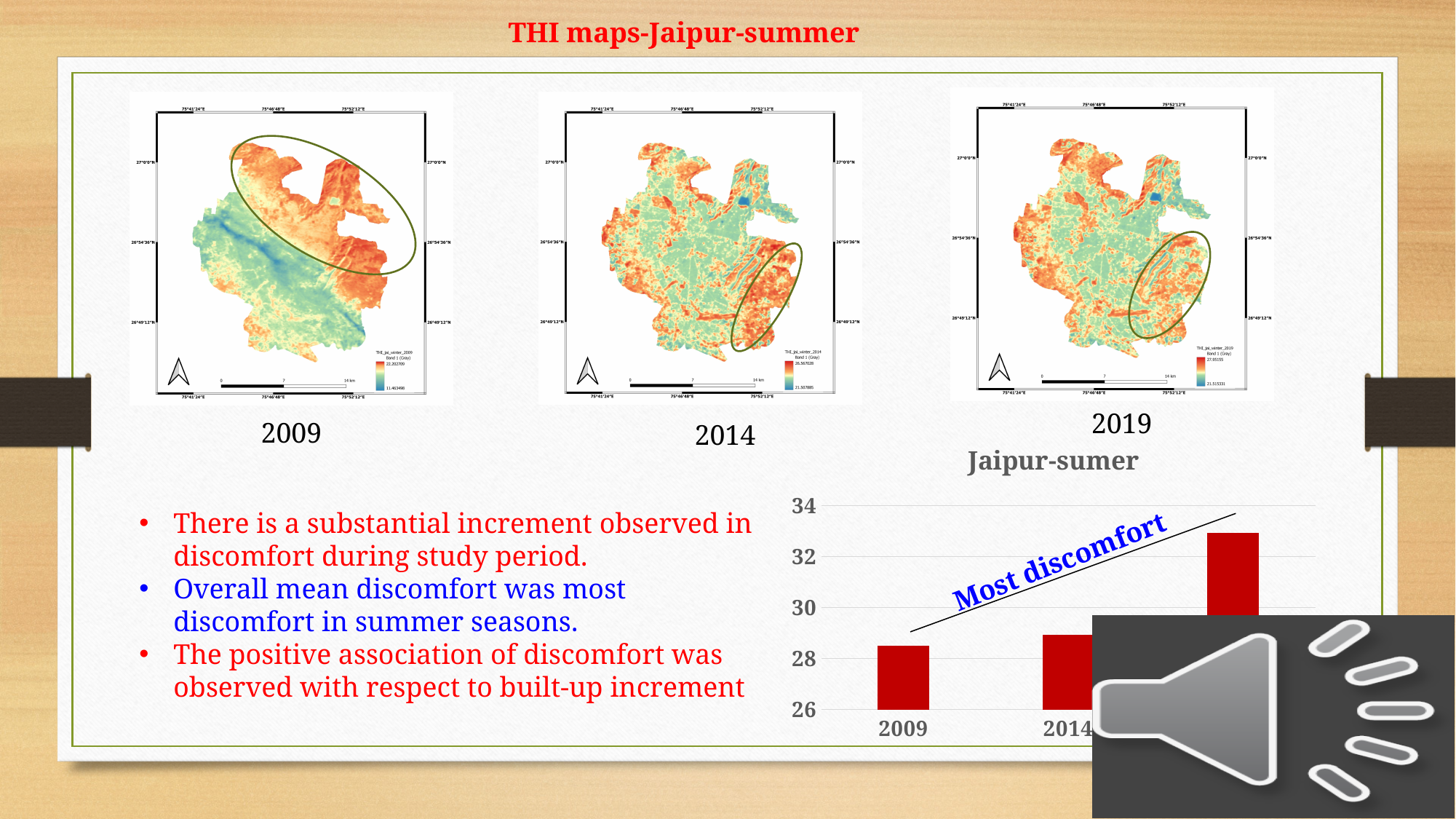
In the 'Jaipur-sumer' chart, is the value for 2014 greater or less than 30? less In the 'Jaipur-sumer' chart, which bar is the highest? the rightmost (third) bar In the 'Jaipur-sumer' chart, is the value for 2009 greater or less than 30? less In the 'Jaipur-sumer' chart, is the value of the rightmost bar greater or less than 34? less What annotation text is written along the arrow above the bars in the 'Jaipur-sumer' chart? Most discomfort In the 'Jaipur-sumer' chart, which is larger: the value for 2009 or the value of the rightmost bar? the rightmost bar What is the title of the bar chart on the slide? Jaipur-sumer How many bars are plotted in the 'Jaipur-sumer' bar chart? 3 What kind of chart is the 'Jaipur-sumer' chart on the slide? bar chart In the 'Jaipur-sumer' chart, do the values rise or fall from left to right along the x axis? rise